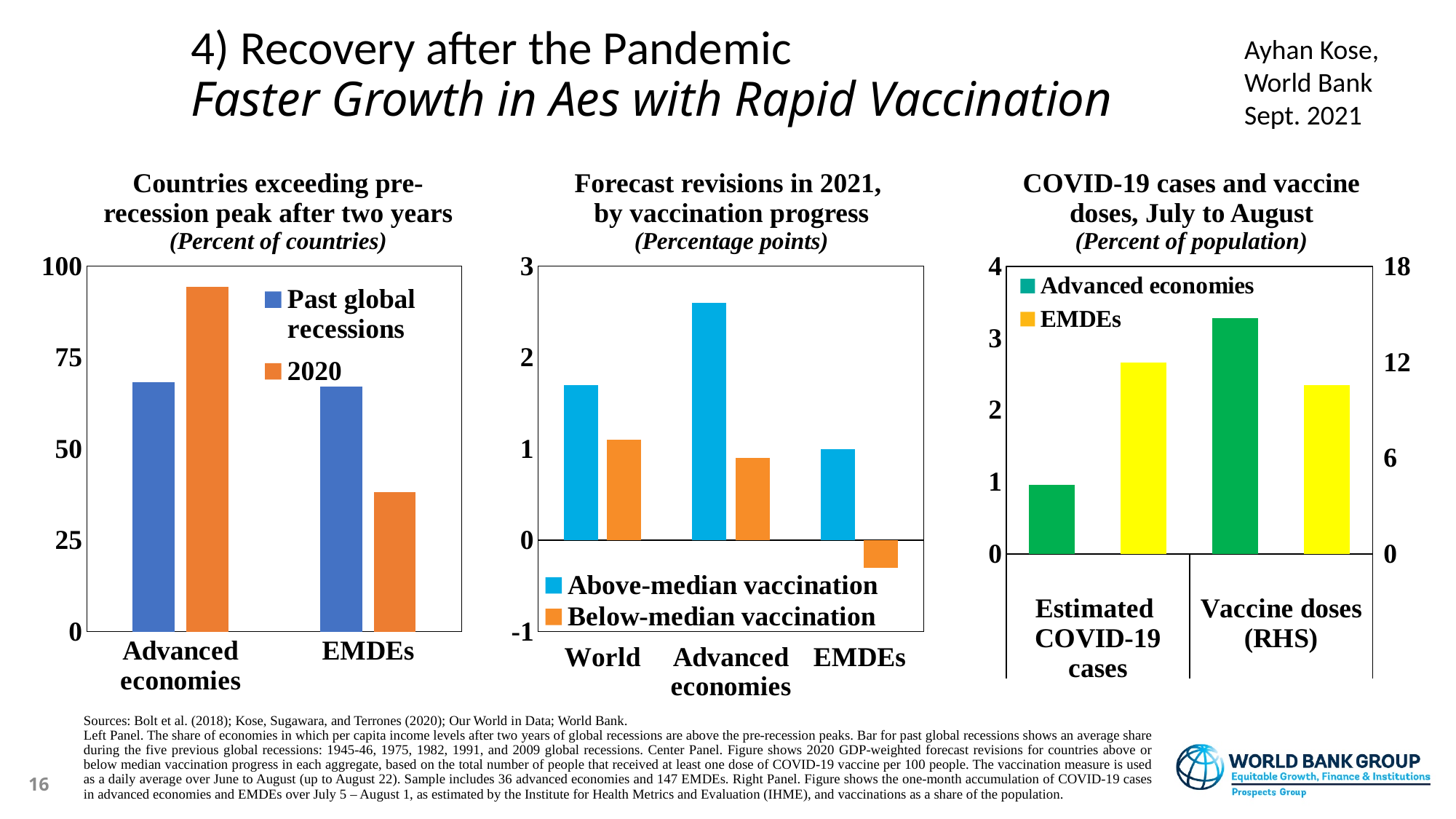
In the chart 'Countries exceeding pre-recession peak after two years', which bar is the tallest? Advanced economies, 2020 In the chart 'Forecast revisions in 2021, by vaccination progress', is the Above-median vaccination value for Advanced economies greater or less than 2? greater In the chart 'COVID-19 cases and vaccine doses, July to August', for Estimated COVID-19 cases, which is larger: Advanced economies or EMDEs? EMDEs In the chart 'Countries exceeding pre-recession peak after two years', is the 2020 value for Advanced economies greater or less than 75? greater In the chart 'Forecast revisions in 2021, by vaccination progress', which bar is the lowest? EMDEs, Below-median vaccination In the chart 'Countries exceeding pre-recession peak after two years', is the 2020 value for EMDEs greater or less than 50? less What type of chart is 'COVID-19 cases and vaccine doses, July to August'? bar chart How many series does the legend list in the chart 'Countries exceeding pre-recession peak after two years'? 2 How many categories are shown on the x axis of the chart 'Forecast revisions in 2021, by vaccination progress'? 3 In the chart 'Countries exceeding pre-recession peak after two years', for EMDEs, which is larger: Past global recessions or 2020? Past global recessions